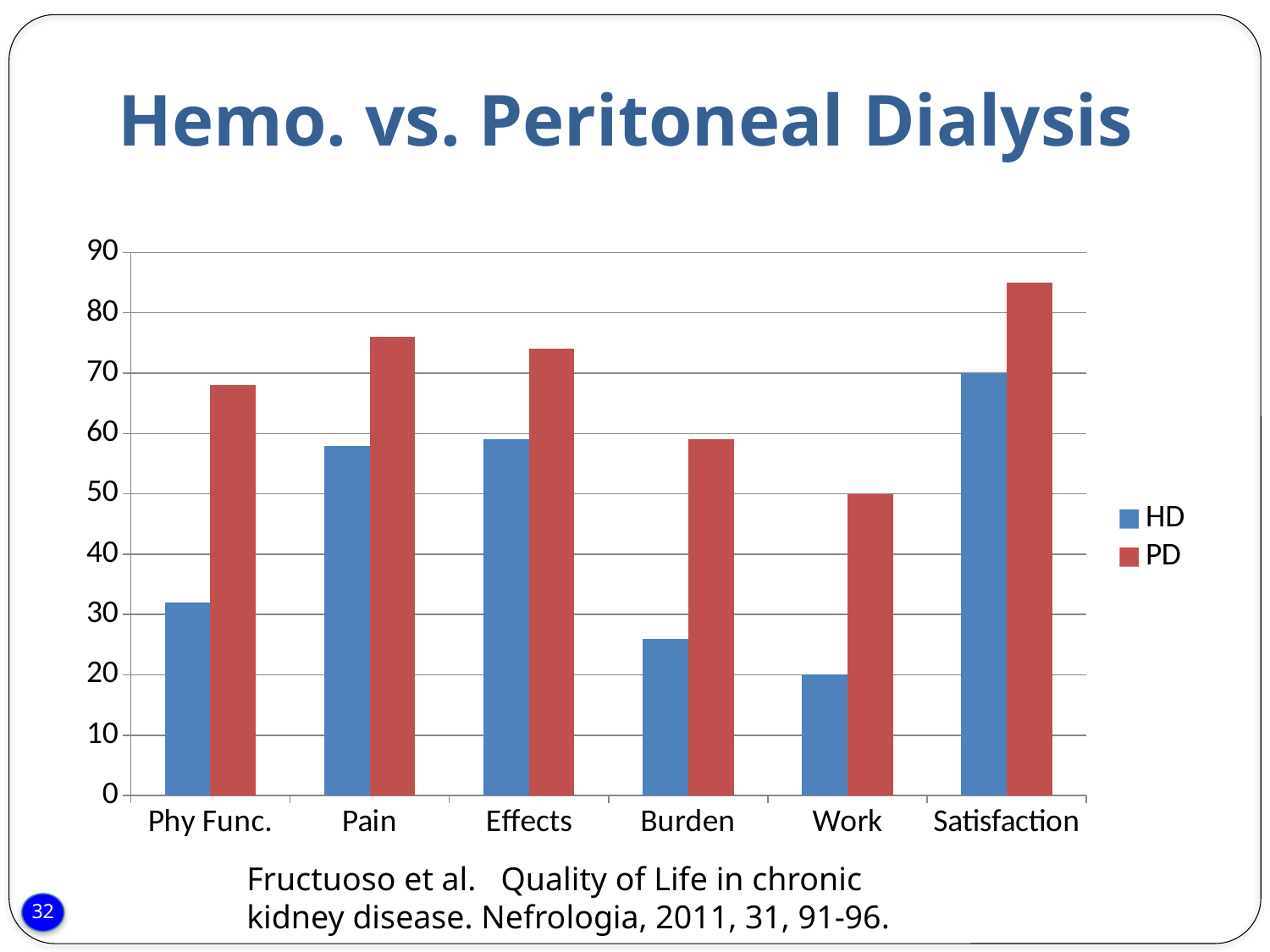
Is the HD value for Pain greater or less than 50? greater Is the PD value for Burden greater or less than 50? greater What kind of chart is shown on the slide? bar chart Which category has the lowest HD value? Work How many categories are shown on the x axis? 6 For Phy Func., which series has the larger value, HD or PD? PD How many series does the legend list? 2 Which category has the highest PD value? Satisfaction Is the HD value for Burden greater or less than 30? less What is the title of the slide containing the chart? Hemo. vs. Peritoneal Dialysis Which category has the lowest PD value? Work